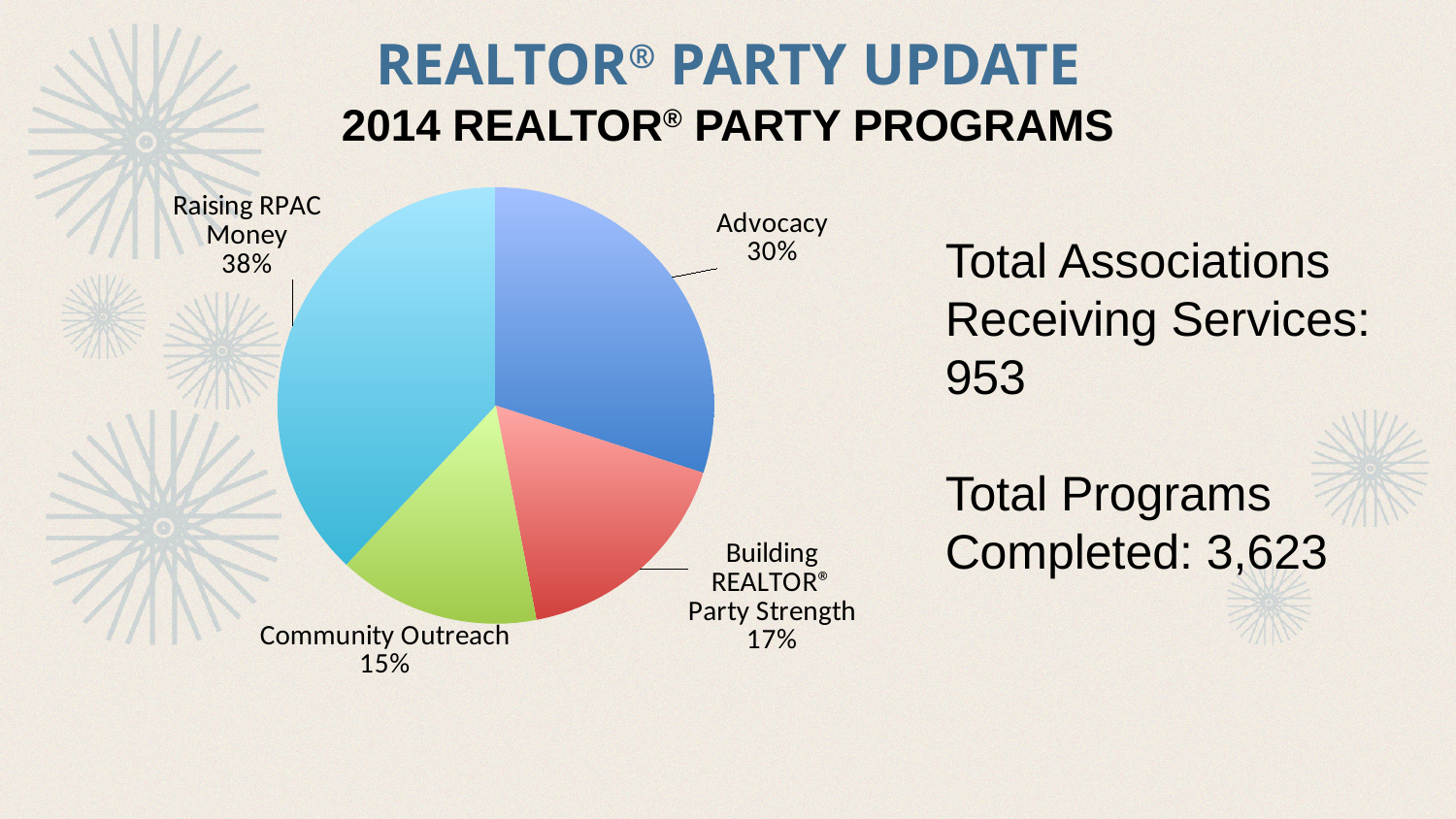
What colour is the Advocacy slice of the pie? Blue What is the difference in percentage points between Raising RPAC Money and Advocacy? 8 What percentage is shown for Community Outreach? 15% What percentage is shown for Building REALTOR Party Strength? 17% What kind of chart is shown on the slide? Pie chart Which category has the largest share of the pie? Raising RPAC Money Which category has the smallest share of the pie? Community Outreach What is the combined percentage of Advocacy and Building REALTOR Party Strength? 47% Which is larger, the share for Building REALTOR Party Strength or the share for Community Outreach? Building REALTOR Party Strength How many categories are shown in the pie chart? 4 What share of the pie does Advocacy represent? 30% What percentage is shown for Raising RPAC Money? 38%